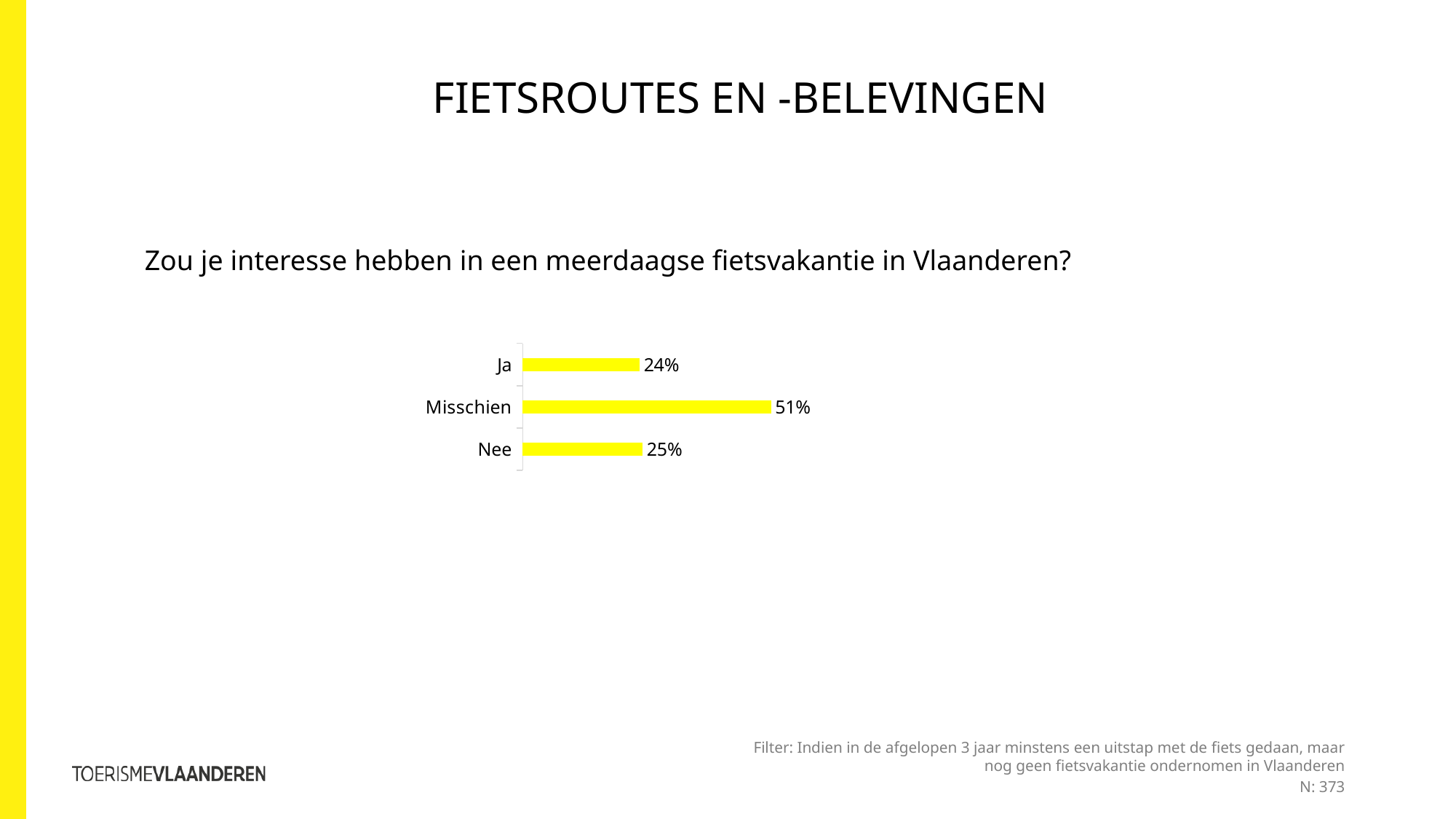
What question does the chart answer, as written above it? Zou je interesse hebben in een meerdaagse fietsvakantie in Vlaanderen? What is the value for "Misschien"? 51% How many categories are shown in the chart? 3 Which category has the highest value? Misschien What is the value for "Ja"? 24% Which is larger, the value for "Misschien" or the value for "Nee"? Misschien What is the value for "Nee"? 25% Which category has the lowest value? Ja What is the difference between the values for "Nee" and "Ja"? 1% What is the difference between the values for "Misschien" and "Ja"? 27% What kind of chart is shown on the slide? Bar chart What colour are the bars in the chart? Yellow